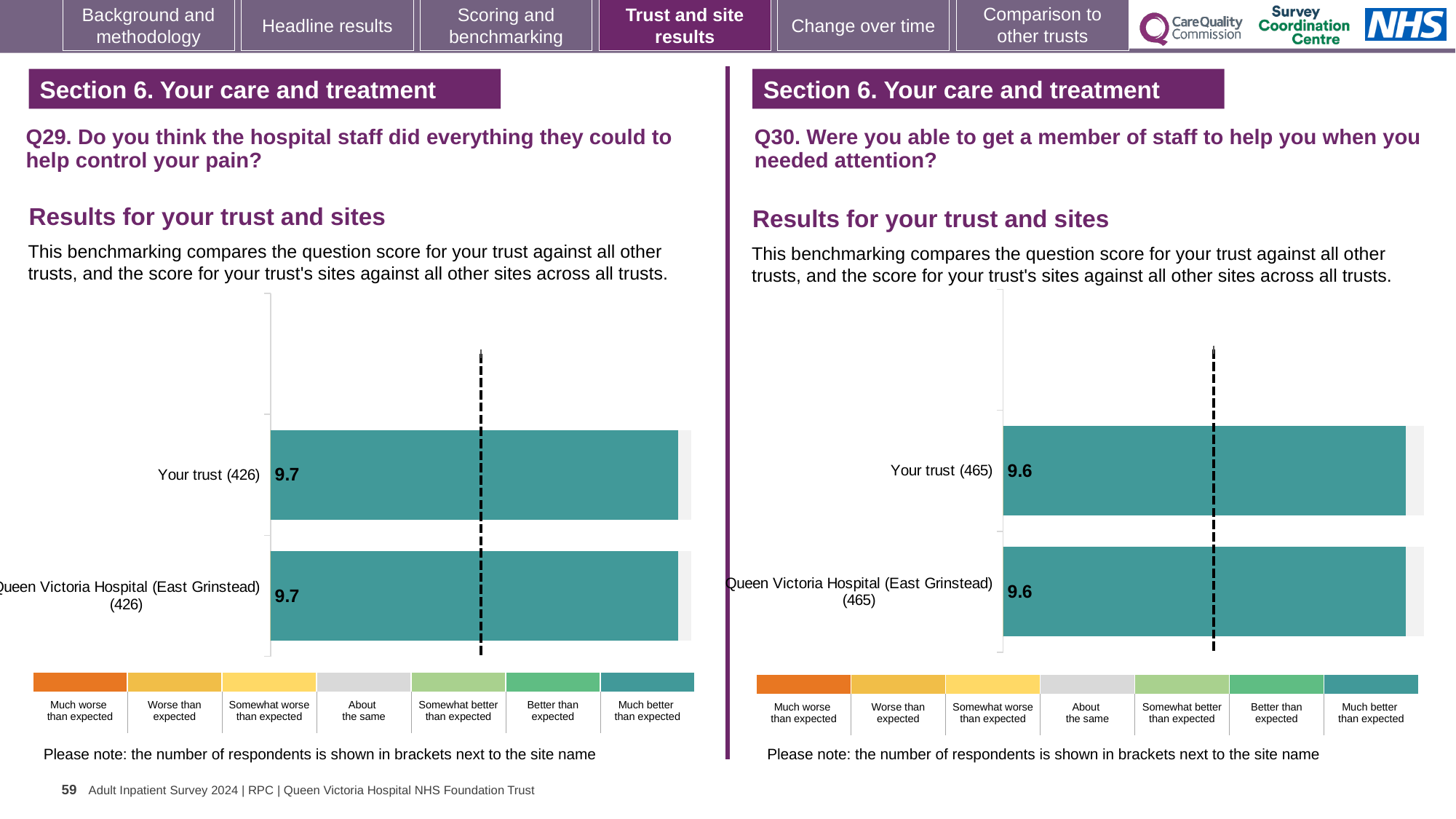
On the Q29 chart (left), what is the difference between the score for Your trust and the score for Queen Victoria Hospital (East Grinstead)? 0.0 On the Q29 chart (left), how many respondents are shown in brackets for Your trust? 426 On the Q30 chart (right), how many respondents are shown in brackets for Queen Victoria Hospital (East Grinstead)? 465 Is the score for Your trust on the Q29 chart (left) larger or smaller than the score for Your trust on the Q30 chart (right)? Larger How many bars are plotted on the Q30 chart (right)? 2 On the Q29 chart (left), what is the score for Your trust (426)? 9.7 On the Q30 chart (right), what is the score for Queen Victoria Hospital (East Grinstead) (465)? 9.6 What kind of chart is used on the Q29 chart (left)? Bar chart On the Q30 chart (right), what is the score for Your trust (465)? 9.6 On the Q29 chart (left), what is the score for Queen Victoria Hospital (East Grinstead) (426)? 9.7 On the Q30 chart (right), what is the difference between the score for Your trust and the score for Queen Victoria Hospital (East Grinstead)? 0.0 How many bars are plotted on the Q29 chart (left)? 2